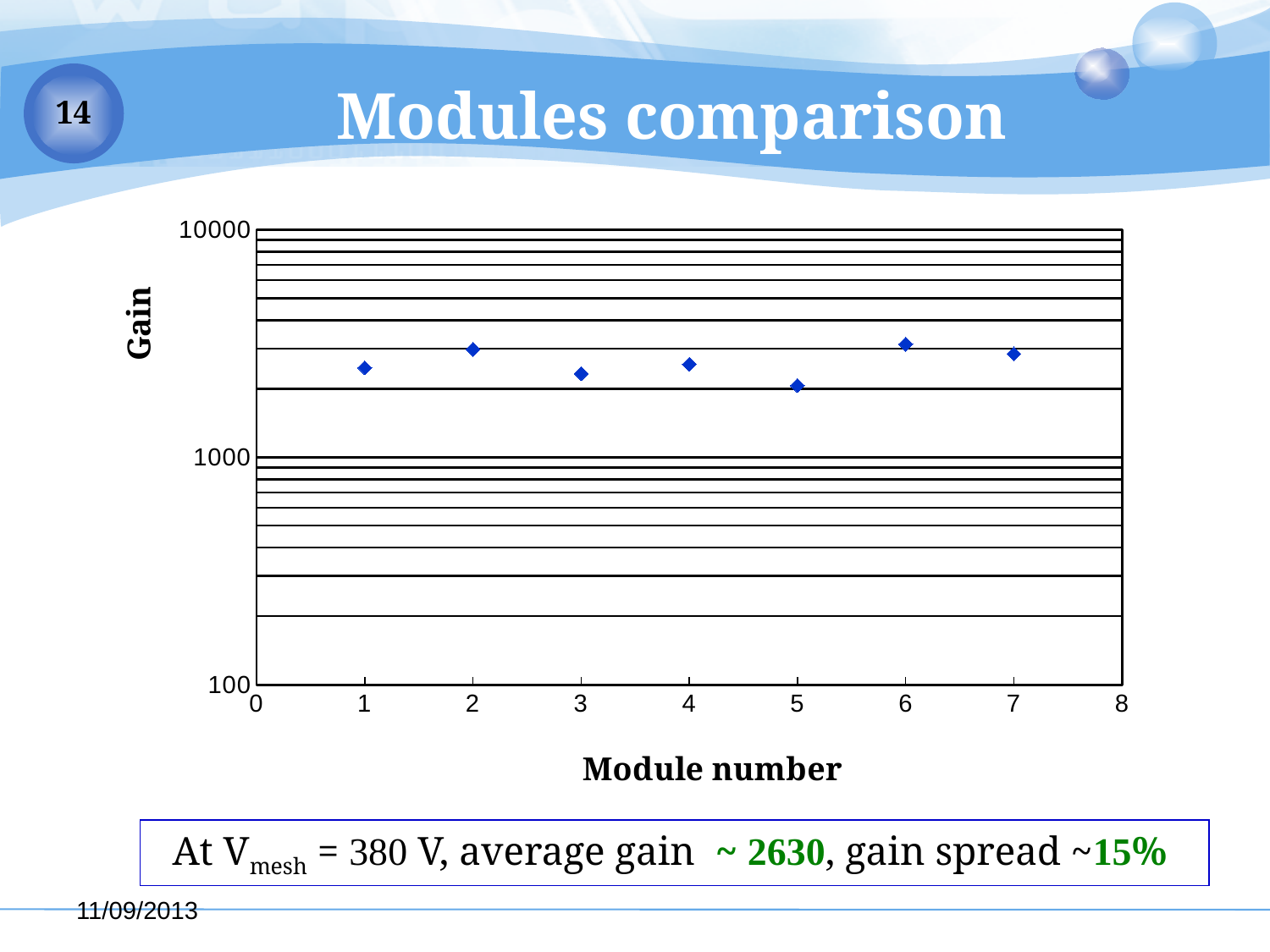
What is the title of the y axis? Gain What kind of chart is shown on the slide? scatter chart Is the gain for module 1 greater or less than 1000? greater Which has the larger gain, module 3 or module 6? module 6 What is the title of the x axis? Module number How many data points are plotted in the chart? 7 Is the gain for module 5 greater or less than 1000? greater Which module number has the highest gain? 6 Which module number has the lowest gain? 5 Which has the larger gain, module 1 or module 5? module 1 Is the gain for module 6 greater or less than 10000? less